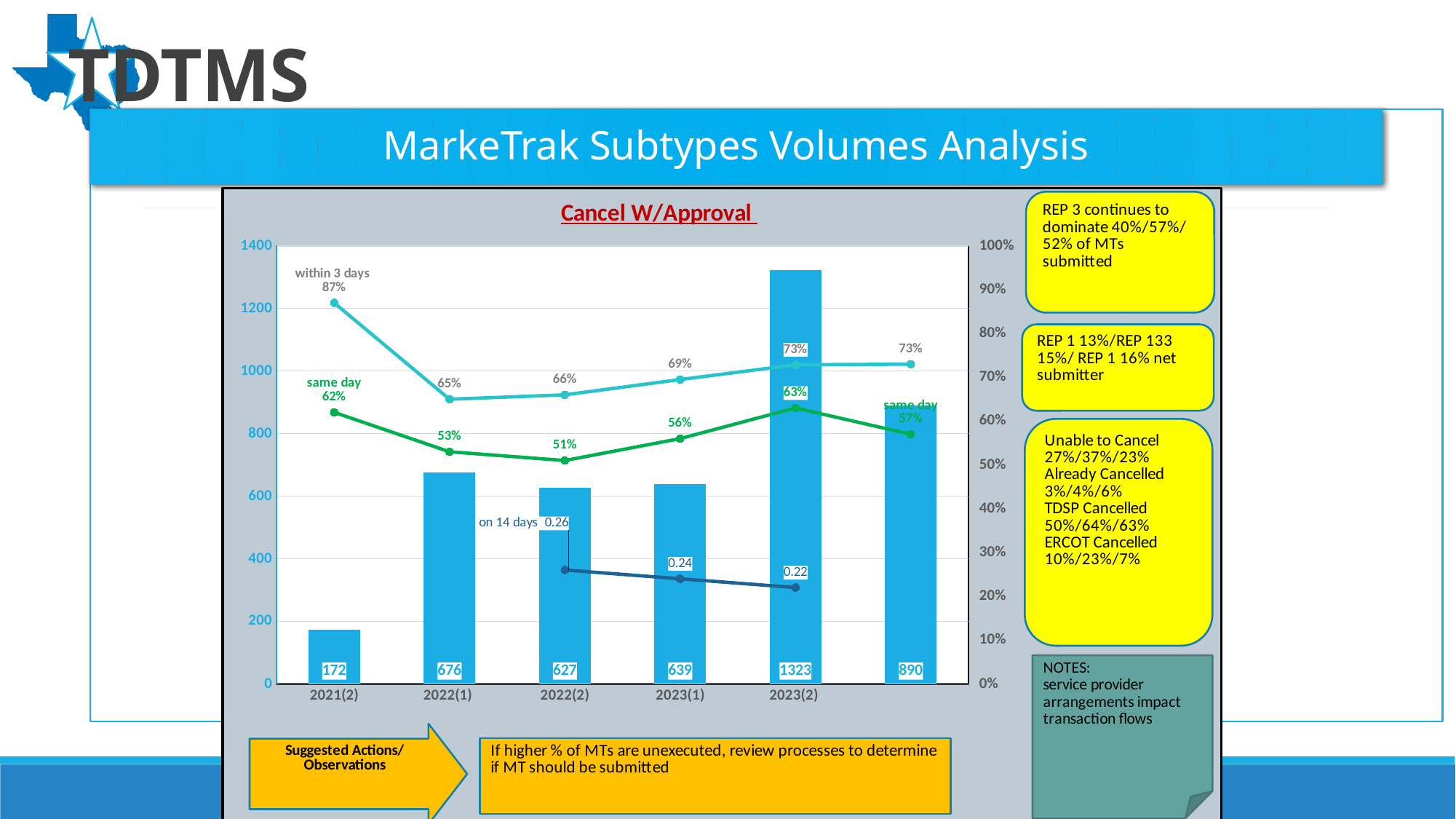
Which labelled period has the highest bar value? 2023(2) What is the difference between the bar values for 2023(2) and 2023(1)? 684 Which labelled period has the lowest bar value? 2021(2) What is the 'on 14 days' value for 2023(2)? 0.22 What is the bar value for 2021(2)? 172 What is the title of the chart? Cancel W/Approval Is the bar value for 2023(2) greater or less than 1200? greater Which is larger, the bar value for 2022(1) or 2022(2)? 2022(1) What is the bar value for 2022(1)? 676 What is the bar value for 2023(2)? 1323 What is the 'same day' percentage for 2022(2)? 51% What is the 'within 3 days' percentage for 2021(2)? 87%